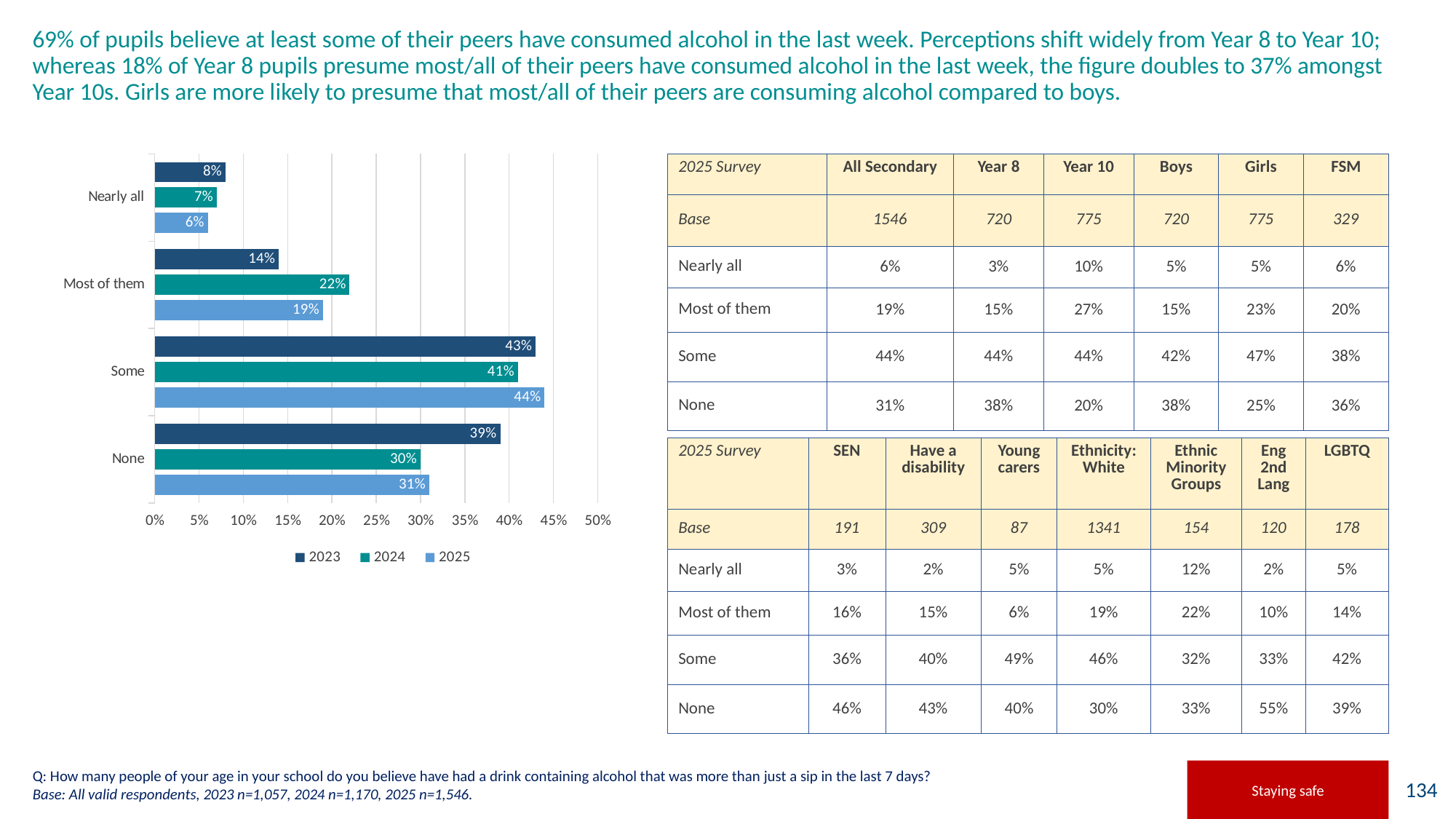
Which category has the highest 2025 value in the chart? Some What is the difference between the 2023 and 2024 values for 'None' in the chart? 9% What is the 2024 value for 'Most of them' in the chart? 22% Which category has the lowest 2023 value in the chart? Nearly all How many categories are shown on the chart's vertical axis? 4 What type of chart is shown on the slide? bar chart Which series in the chart legend is shown in the lightest blue colour? 2025 What is the 2025 value for 'Some' in the chart? 44% How many series does the chart legend list? 3 Is the 2024 value for 'Some' in the chart greater or less than 40%? greater Which is larger in the chart: the 2023 value for 'Most of them' or the 2025 value for 'Most of them'? 2025 What is the 2023 value for 'None' in the chart? 39%